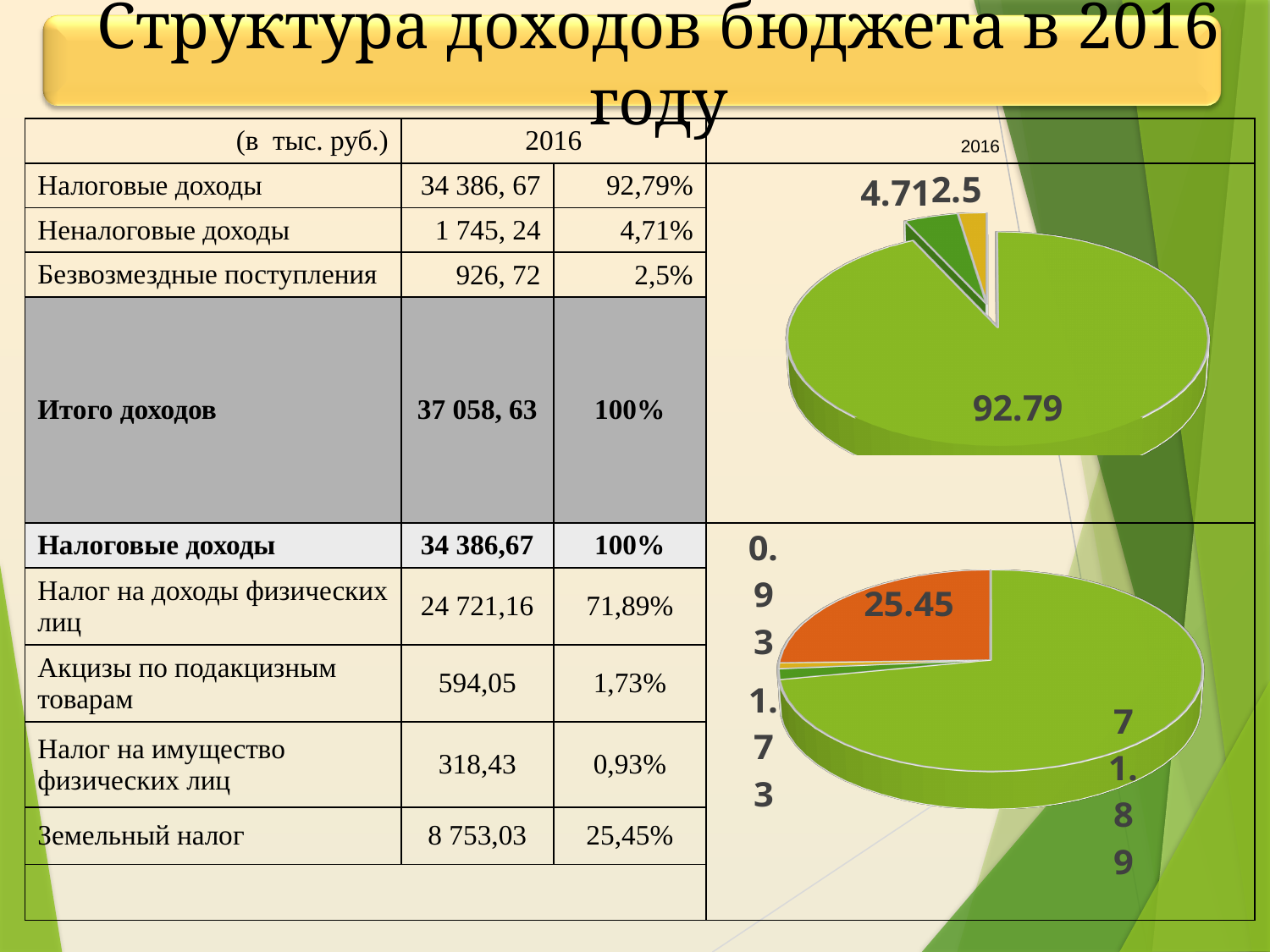
What kind of chart is shown in the bottom right of the slide? pie chart In the top pie chart, what is the value shown on the largest slice? 92.79 In the bottom pie chart, what is the value shown on the orange slice? 25.45 In the bottom pie chart, what is the value shown on the largest slice? 71.89 In the bottom pie chart, what is the difference between the largest slice (71.89) and the orange slice (25.45)? 46.44 In the bottom pie chart, what is the value shown on the smallest slice? 0.93 How many slices does the bottom pie chart have? 4 What kind of chart is shown in the top right of the slide? pie chart In the top pie chart, what is the value shown on the smallest slice? 2.5 How many slices does the top pie chart have? 3 What is the title of the top pie chart? 2016 In the top pie chart, which is larger: the slice labelled 4.71 or the slice labelled 2.5? 4.71